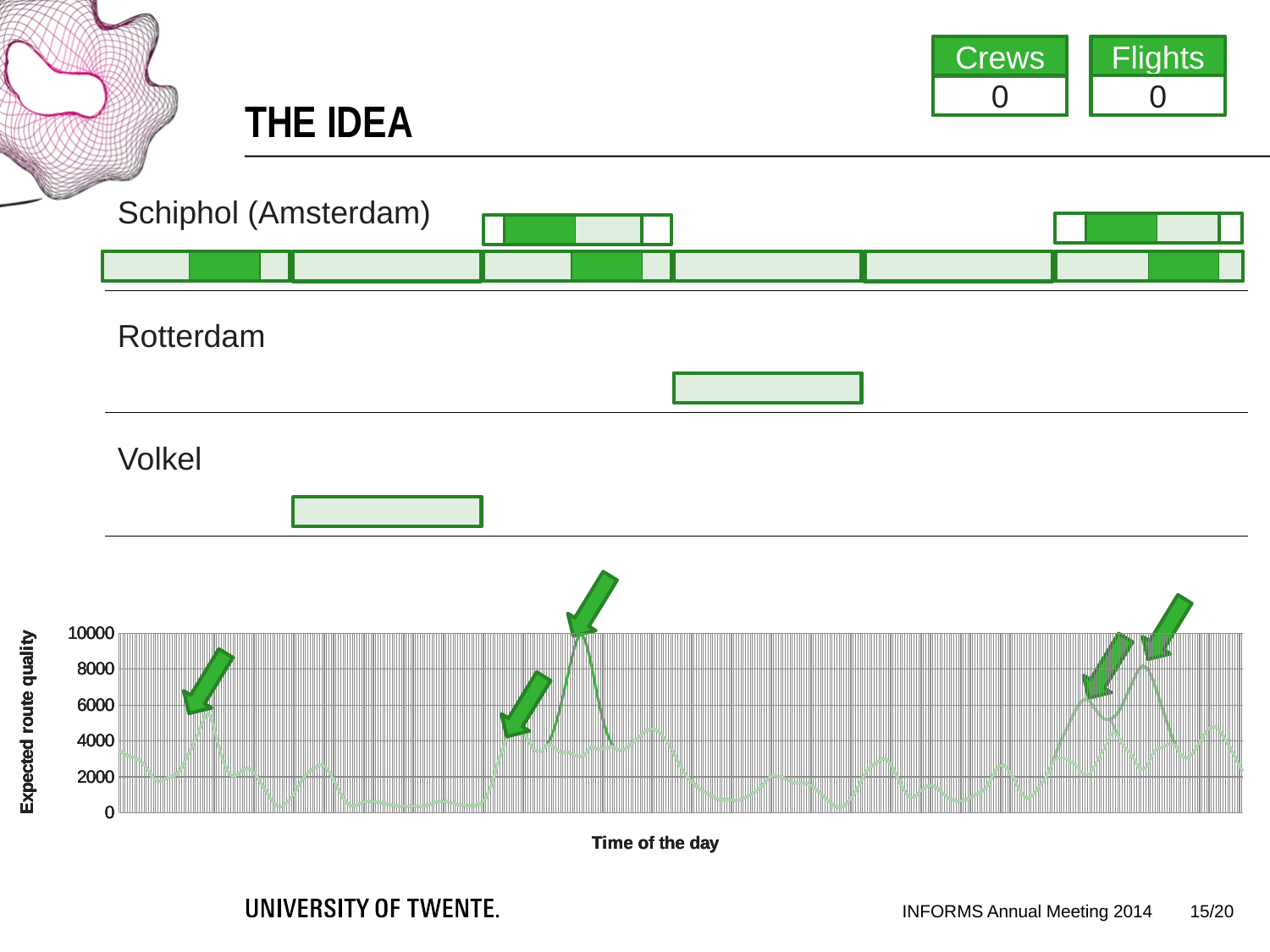
In the chart at the bottom of the slide, is the lowest point of the line greater or less than 2000? less What kind of chart is shown at the bottom of the slide? line chart In the chart at the bottom of the slide, is the highest peak of the line greater or less than 8000? greater What is the title of the horizontal axis of the chart at the bottom of the slide? Time of the day In the chart at the bottom of the slide, is the peak marked by the leftmost green arrow greater or less than 4000? greater What is the title of the vertical axis of the chart at the bottom of the slide? Expected route quality